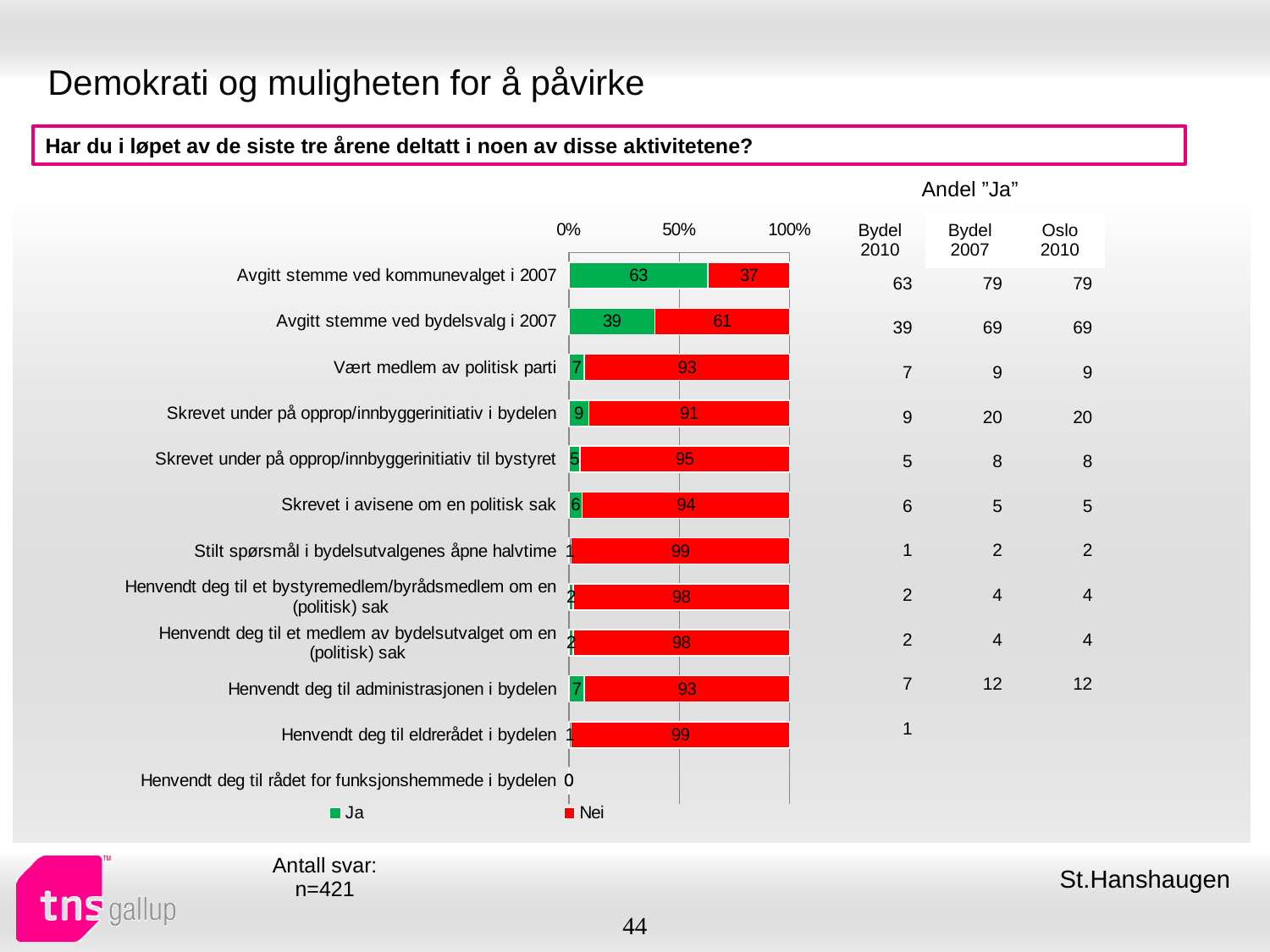
What is the "Ja" value for "Avgitt stemme ved kommunevalget i 2007"? 63 Which category has the highest "Ja" value? Avgitt stemme ved kommunevalget i 2007 Which category has the lowest "Ja" value? Henvendt deg til rådet for funksjonshemmede i bydelen How many activity categories are plotted in the chart? 12 What is the difference between the "Ja" values for "Avgitt stemme ved kommunevalget i 2007" and "Avgitt stemme ved bydelsvalg i 2007"? 24 Is the "Nei" value for "Vært medlem av politisk parti" greater or less than 50%? greater How many series does the chart legend list? 2 What is the "Nei" value for "Avgitt stemme ved bydelsvalg i 2007"? 61 What kind of chart is shown on the slide? bar chart What is the "Ja" value for "Skrevet under på opprop/innbyggerinitiativ i bydelen"? 9 What is the total of the stacked bar for "Avgitt stemme ved kommunevalget i 2007"? 100 Which has a larger "Nei" value: "Vært medlem av politisk parti" or "Skrevet under på opprop/innbyggerinitiativ til bystyret"? Skrevet under på opprop/innbyggerinitiativ til bystyret